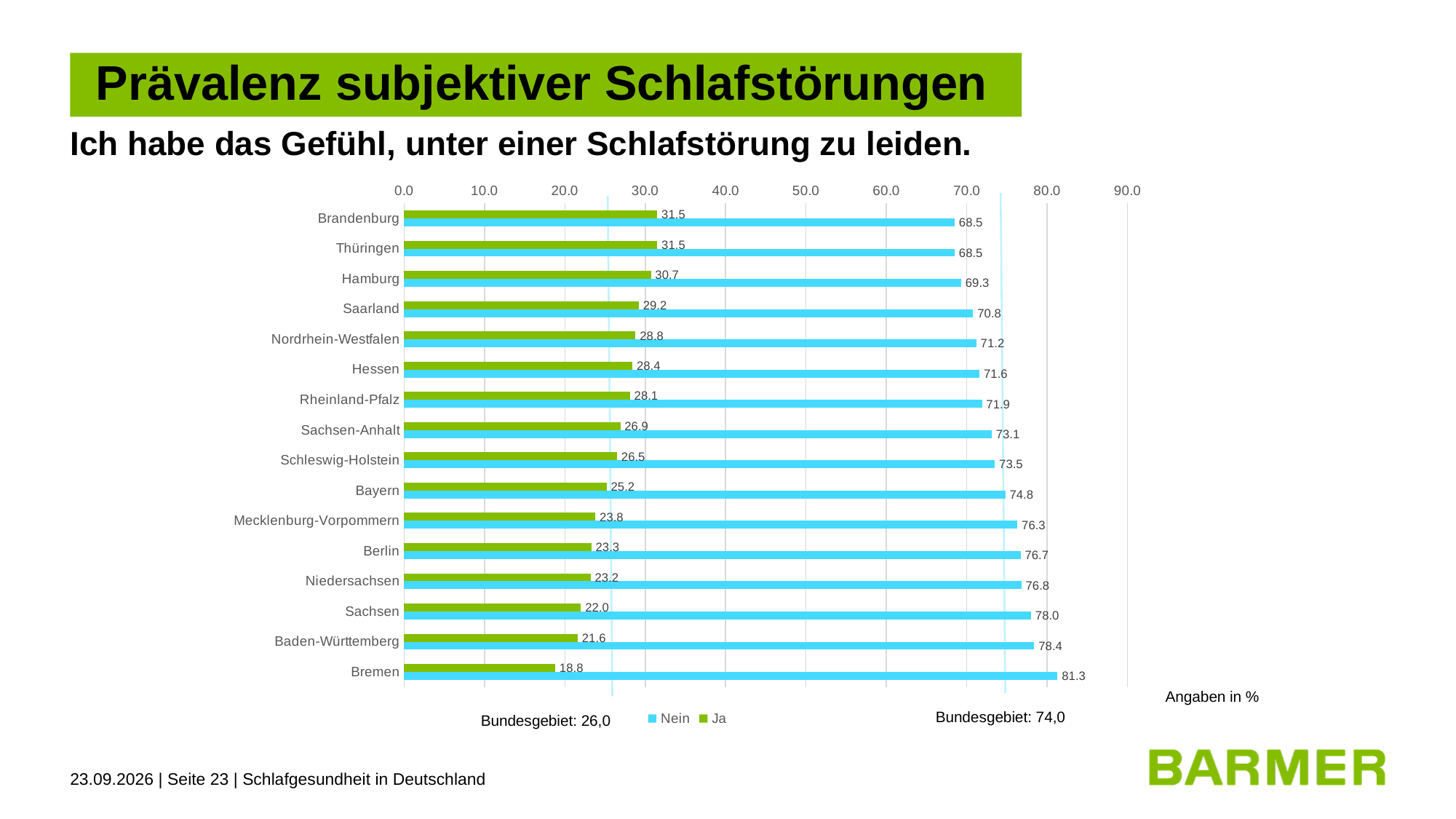
What kind of chart is shown on the slide? Bar chart What is the total of the "Ja" and "Nein" values for Saarland? 100.0 What is the difference between the "Nein" value for Bremen and the "Nein" value for Brandenburg? 12.8 How many categories (federal states) are shown in the chart? 16 Which series is shown in green in the chart? Ja What is the "Ja" value for Sachsen? 22.0 What is the "Ja" value for Hamburg? 30.7 What is the "Nein" value for Bremen? 81.3 Which category has the lowest "Ja" value? Bremen How many series does the legend list? 2 Which category has the highest "Nein" value? Bremen Which is larger: the "Ja" value for Bayern or the "Ja" value for Berlin? Bayern